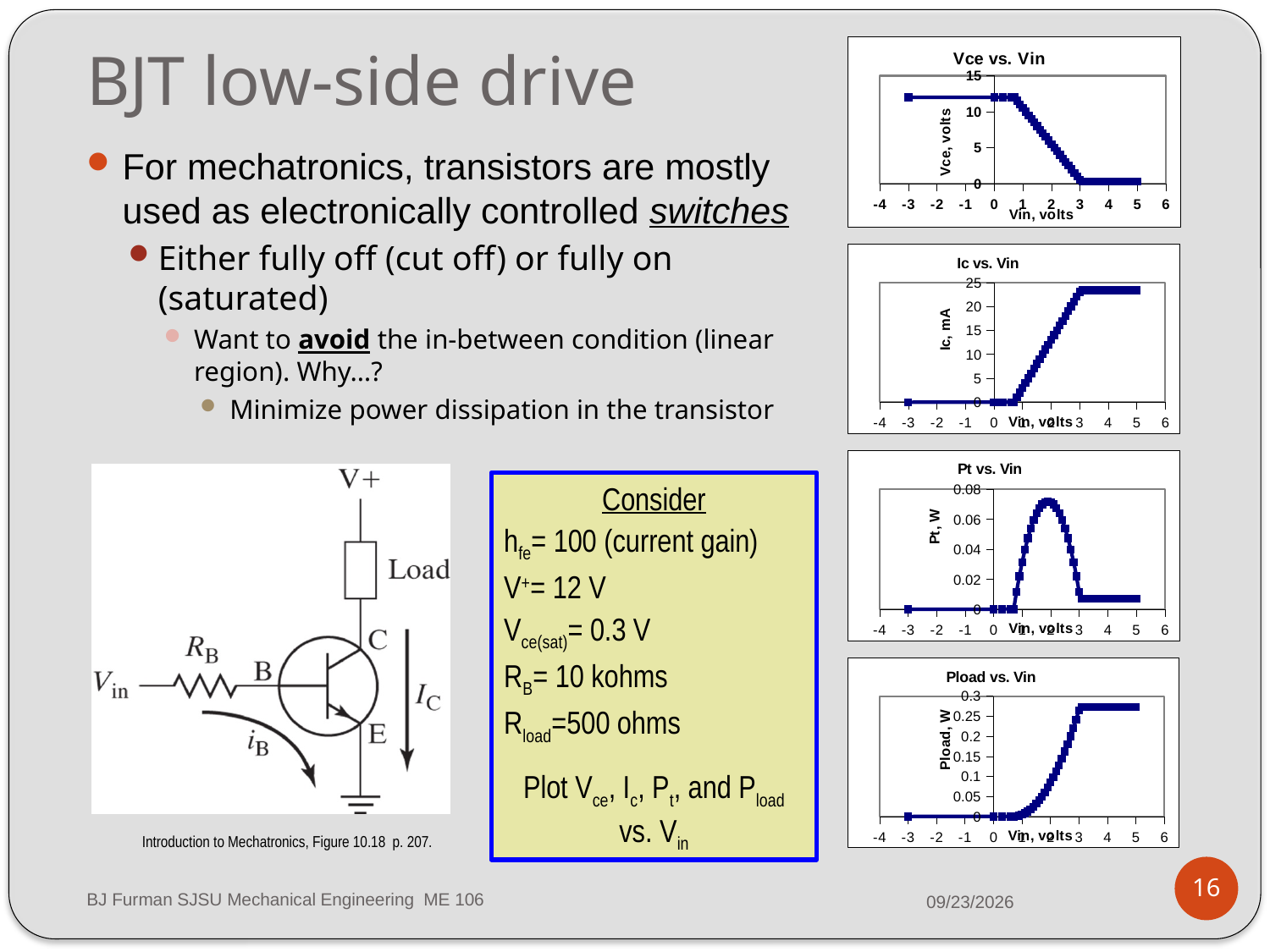
In the 'Pload vs. Vin' chart, do the values rise or fall as Vin increases? rise In the 'Ic vs. Vin' chart, is the value at Vin = -1 greater or less than 5? less In the 'Ic vs. Vin' chart, do the values rise or fall as Vin increases? rise In the 'Vce vs. Vin' chart, what is the y-axis title? Vce, volts In the 'Ic vs. Vin' chart, is the value at Vin = 5 greater or less than 20? greater In the 'Vce vs. Vin' chart, is the value at Vin = 4 greater or less than 5? less How many charts are shown on the slide? 4 In the 'Vce vs. Vin' chart, do the values rise or fall as Vin increases? fall What kind of chart is the 'Ic vs. Vin' chart? scatter chart